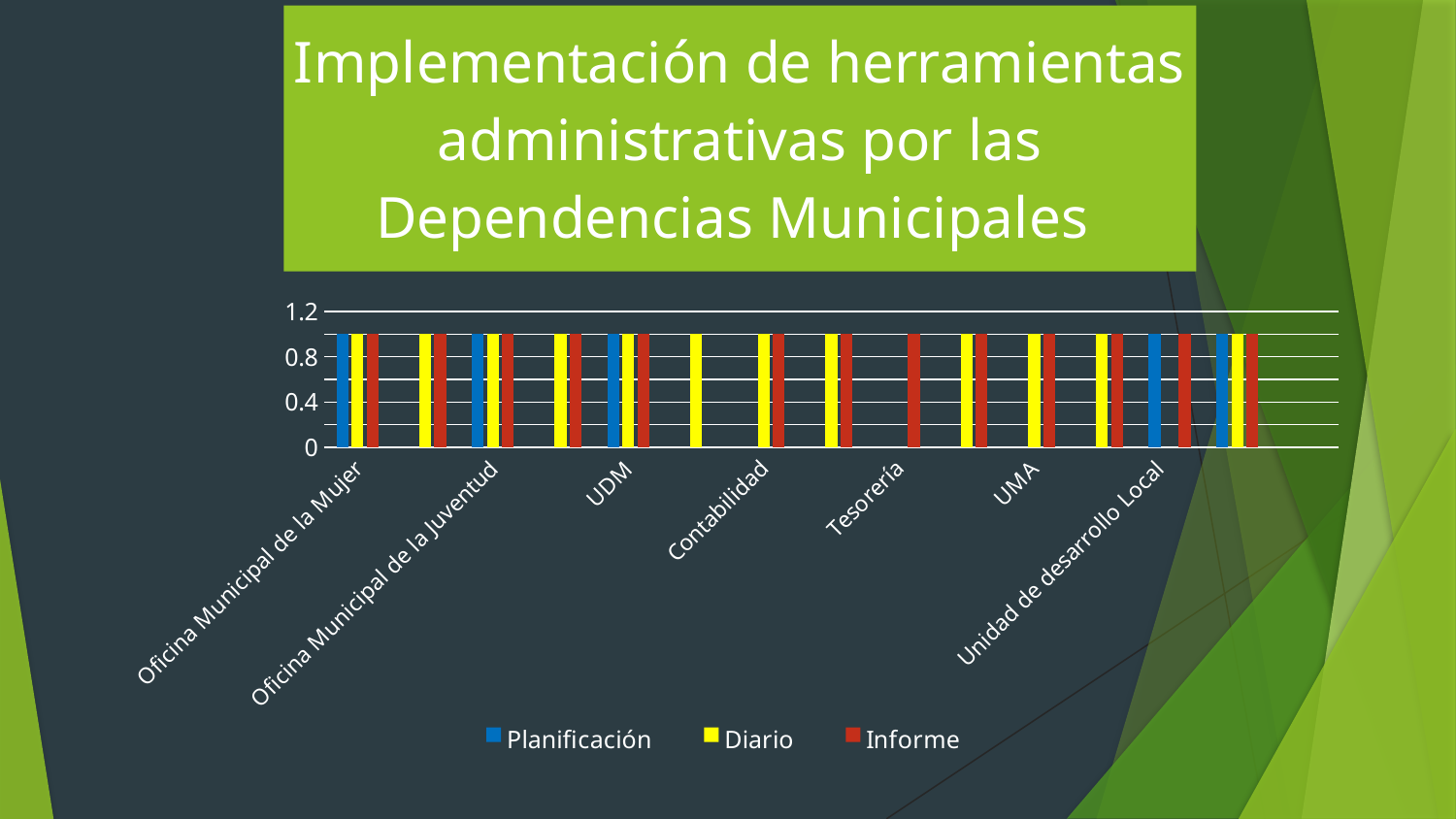
Is the Diario value for UDM greater or less than 0.8? greater Is the Planificación value for Oficina Municipal de la Mujer greater or less than 1.2? less What is the highest value shown on the vertical axis? 1.2 What are the three series named in the legend? Planificación, Diario, Informe How many series does the legend list? 3 Is the Informe value for Tesorería greater or less than 0.8? greater What kind of chart is shown on the slide? bar chart What is the title of the chart on the slide? Implementación de herramientas administrativas por las Dependencias Municipales